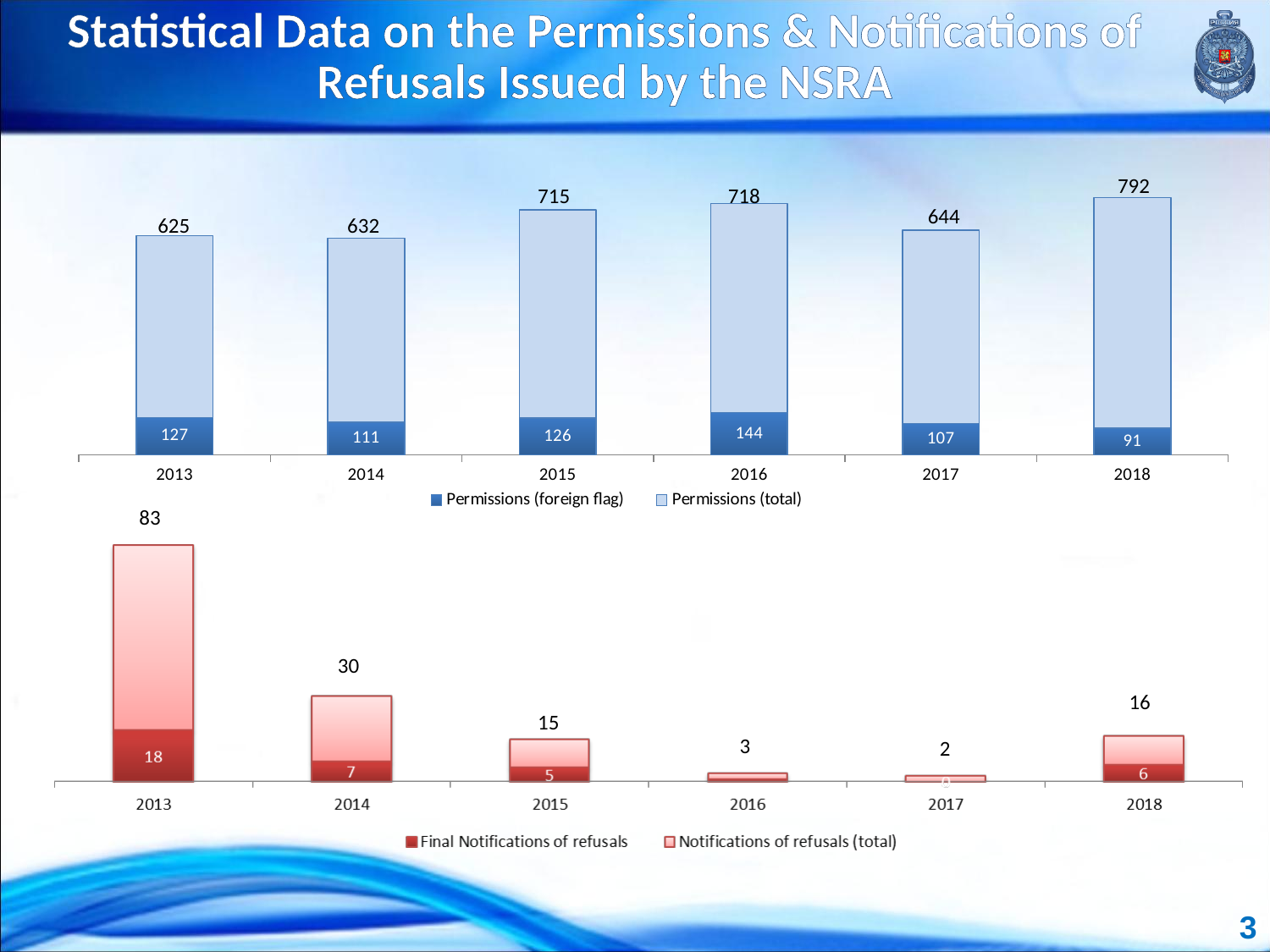
How many series does the legend of the top chart list? 2 In the top chart, which year has the highest Permissions (total)? 2018 In the top chart, which year has the lowest Permissions (foreign flag)? 2018 In the top chart, which is larger: Permissions (foreign flag) in 2013 or in 2014? 2013 In the bottom chart, what is the difference between Notifications of refusals (total) in 2013 and in 2014? 53 In the top chart, what is the value for Permissions (foreign flag) in 2016? 144 In the bottom chart, which year has the lowest Notifications of refusals (total)? 2017 In the bottom chart, what is the value for Notifications of refusals (total) in 2013? 83 How many years are shown on the x axis of the bottom chart? 6 In the top chart, what is the value for Permissions (total) in 2018? 792 In the bottom chart, what is the value for Final Notifications of refusals in 2015? 5 In the top chart, what is the difference between Permissions (total) in 2018 and in 2017? 148